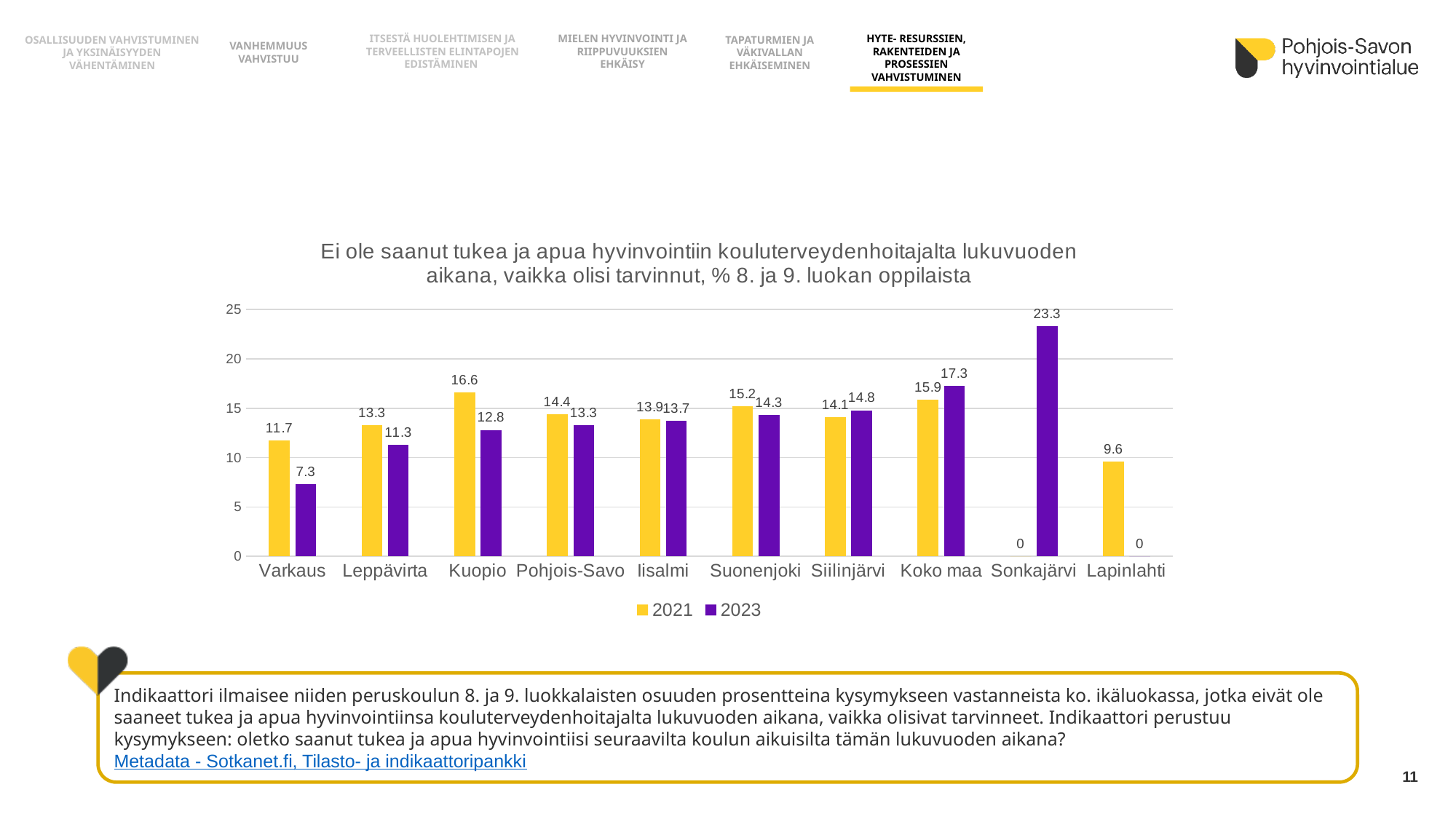
What is the value for Kuopio in 2021? 16.6 Which colour represents the 2021 series? Yellow What is the value for Varkaus in 2023? 7.3 Is the 2023 value for Sonkajärvi greater or less than 20? greater Which is larger for Siilinjärvi, the 2021 value or the 2023 value? 2023 What is the value for Koko maa in 2023? 17.3 What kind of chart is shown on the slide? Bar chart Which category has the lowest non-zero value in the 2021 series? Lapinlahti What is the difference between the 2021 and 2023 values for Kuopio? 3.8 How many categories are shown on the x axis? 10 How many series does the legend list? 2 Which category has the highest value in the 2023 series? Sonkajärvi